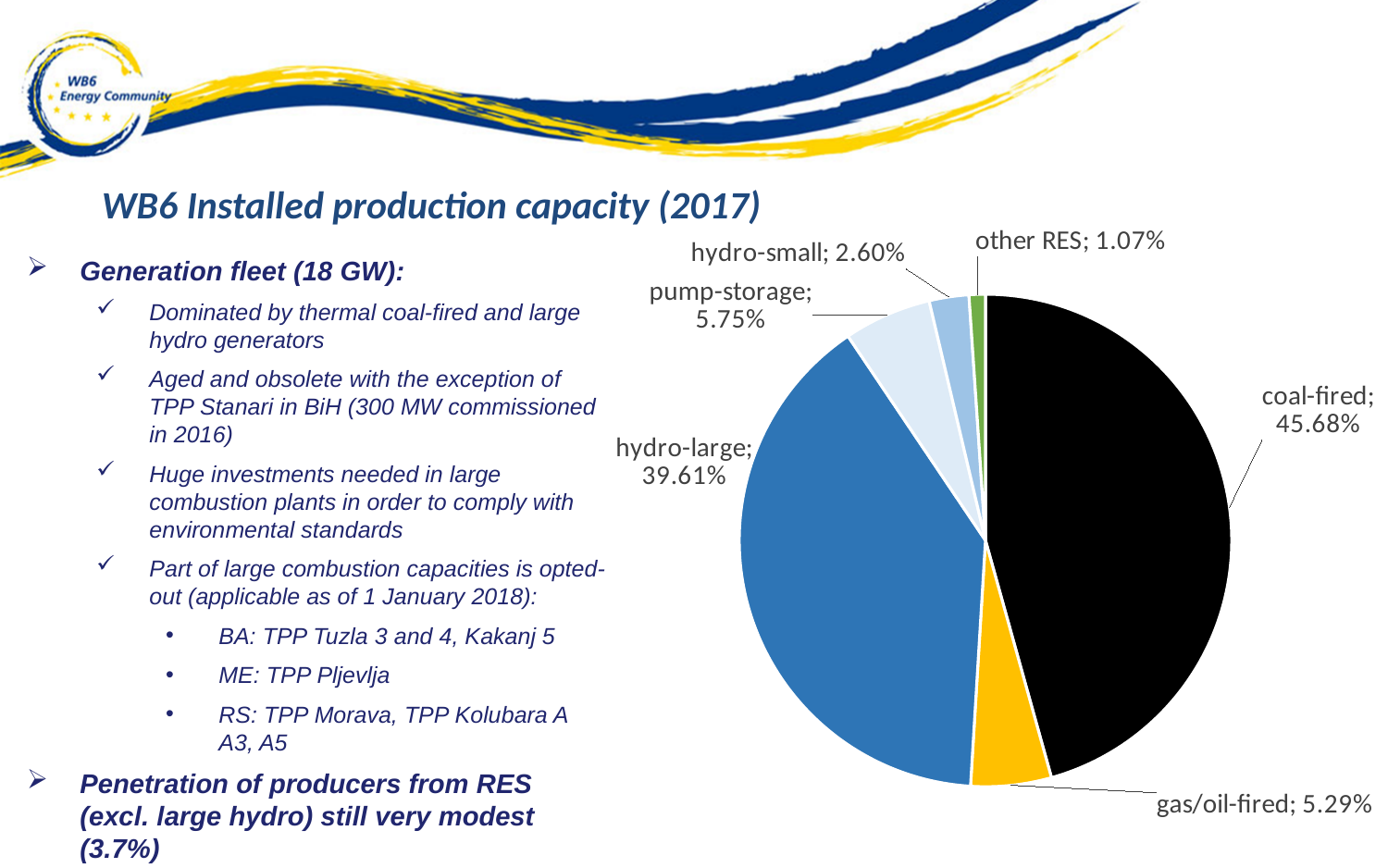
What kind of chart is shown on the slide? pie chart What is the difference between the coal-fired and hydro-large shares? 6.07% How many categories are shown in the pie chart? 6 What share of the pie chart is coal-fired? 45.68% Which category has the largest share of the pie chart? coal-fired What colour is the coal-fired slice of the pie chart? black What share of the pie chart is gas/oil-fired? 5.29% Which category has the smallest share of the pie chart? other RES What share of the pie chart is other RES? 1.07% What share of the pie chart is hydro-large? 39.61% Which is larger, the pump-storage share or the hydro-small share? pump-storage What share of the pie chart is pump-storage? 5.75%